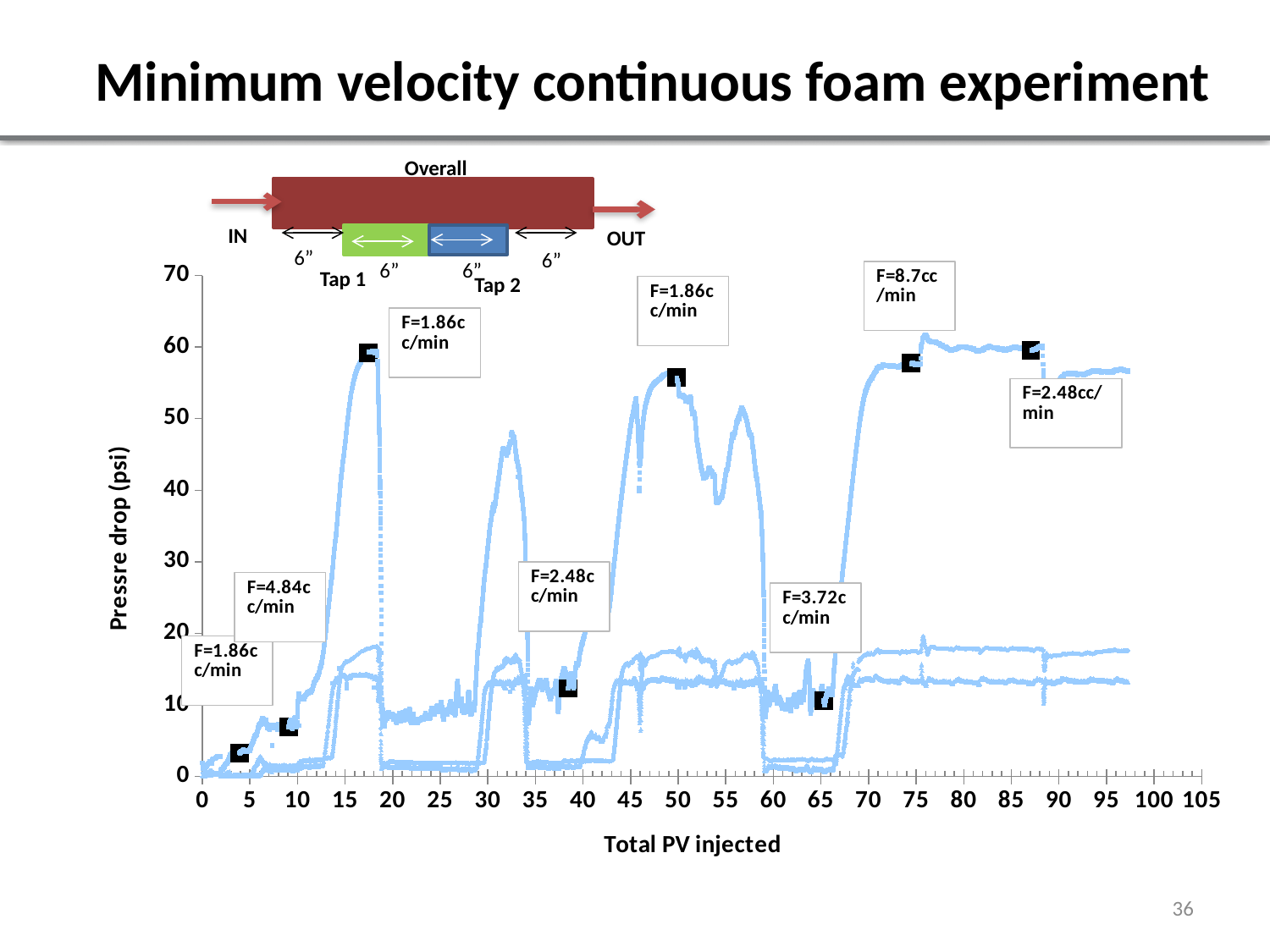
What is the title of the x axis of the chart? Total PV injected Is the value of the top line at 90 PV injected greater or less than 50 psi? greater What kind of chart is shown on the slide? line chart Is the value of the top line at 25 PV injected greater or less than 20 psi? less Is the value of the top line at 75 PV injected greater or less than 40 psi? greater What is the title of the y axis of the chart? Pressre drop (psi) What flow rate is annotated on the chart near 65 PV injected? F=3.72cc/min What flow rate is annotated on the chart near 75 PV injected? F=8.7cc/min What is the highest value shown on the y axis of the chart? 70